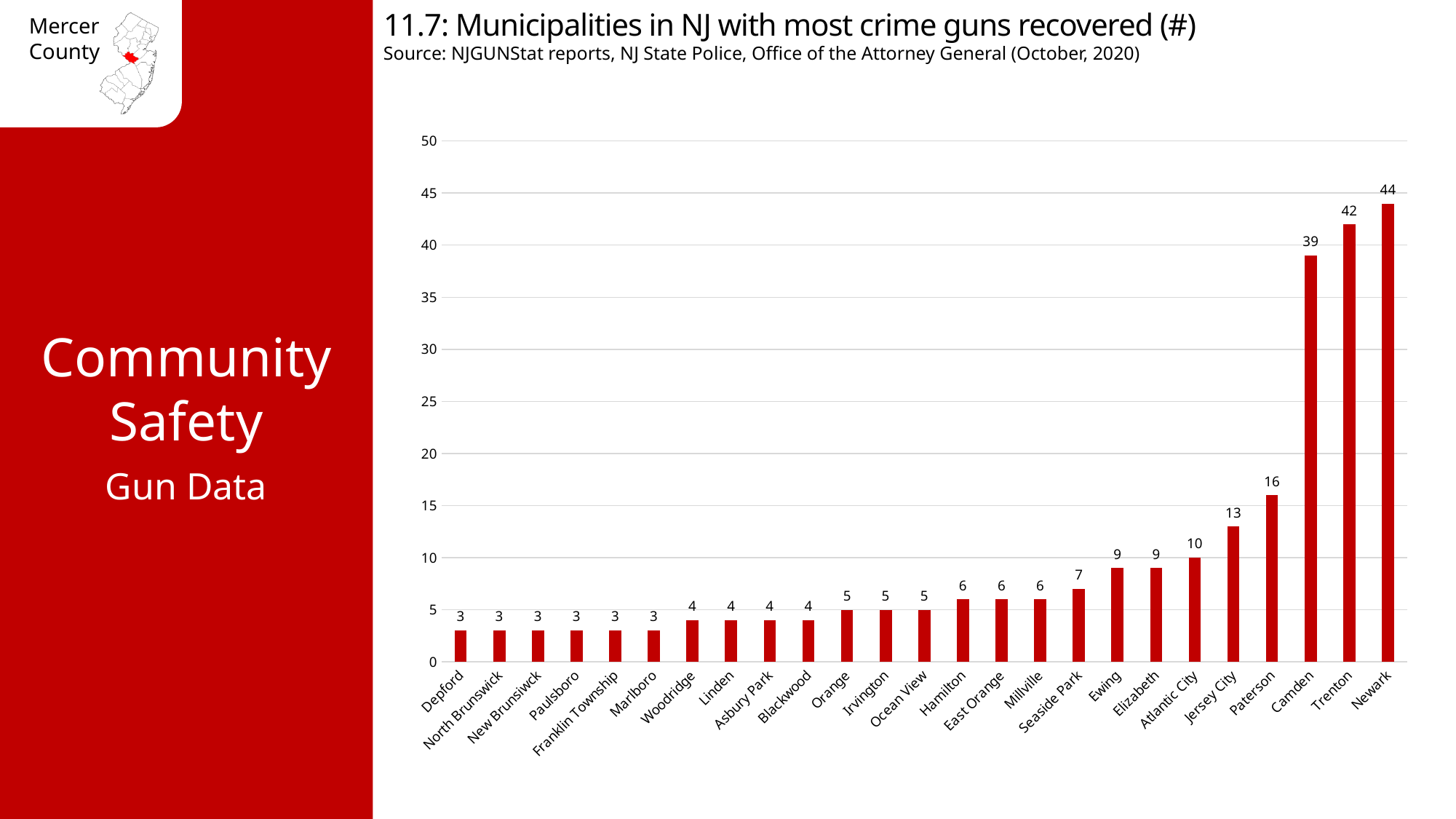
What is the difference between the values for Paterson and Jersey City? 3 How many municipalities are shown on the chart? 25 What is the value shown for Ewing? 9 Which municipality has the highest number of crime guns recovered? Newark What is the value shown for Camden? 39 How many crime guns were recovered in Hamilton? 6 How many crime guns were recovered in Trenton? 42 Which has a higher value, Atlantic City or Seaside Park? Atlantic City What is the difference between the values for Newark and Trenton? 2 Do the values rise or fall moving from left to right along the x axis? Rise Which has a higher value, Camden or Paterson? Camden What kind of chart is shown on the slide? Bar chart